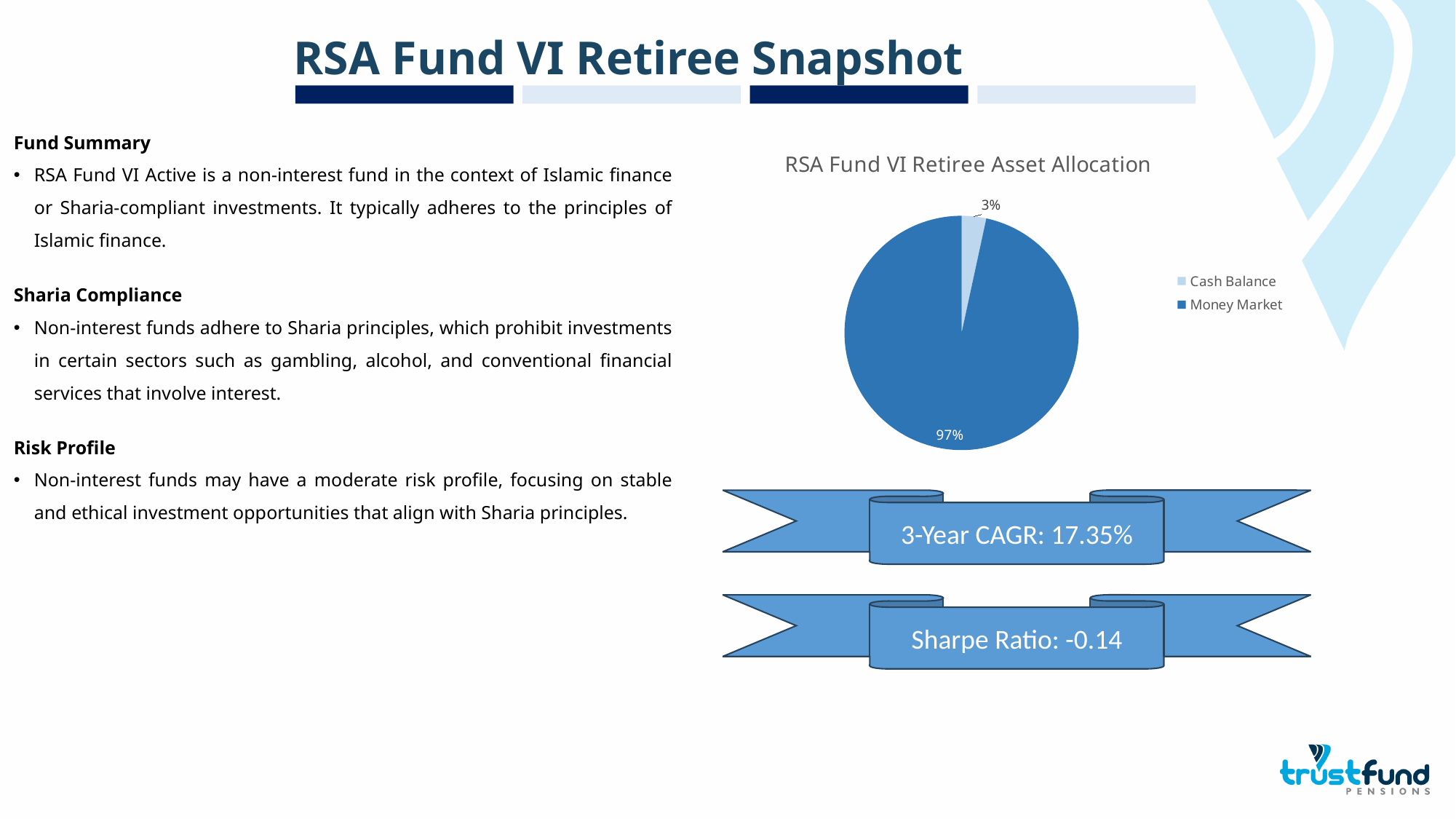
How many entries does the legend list? 2 How many categories does the pie chart show? 2 Which is larger, the Cash Balance slice or the Money Market slice? Money Market Which category has the largest slice of the pie? Money Market What share of the pie does Money Market represent? 97% Which legend entry is shown in the lighter blue colour? Cash Balance Which category has the smallest slice of the pie? Cash Balance What kind of chart is shown on the slide? pie chart What is the title of the chart? RSA Fund VI Retiree Asset Allocation What is the difference in percentage points between the Money Market and Cash Balance slices? 94 What share of the pie does Cash Balance represent? 3%